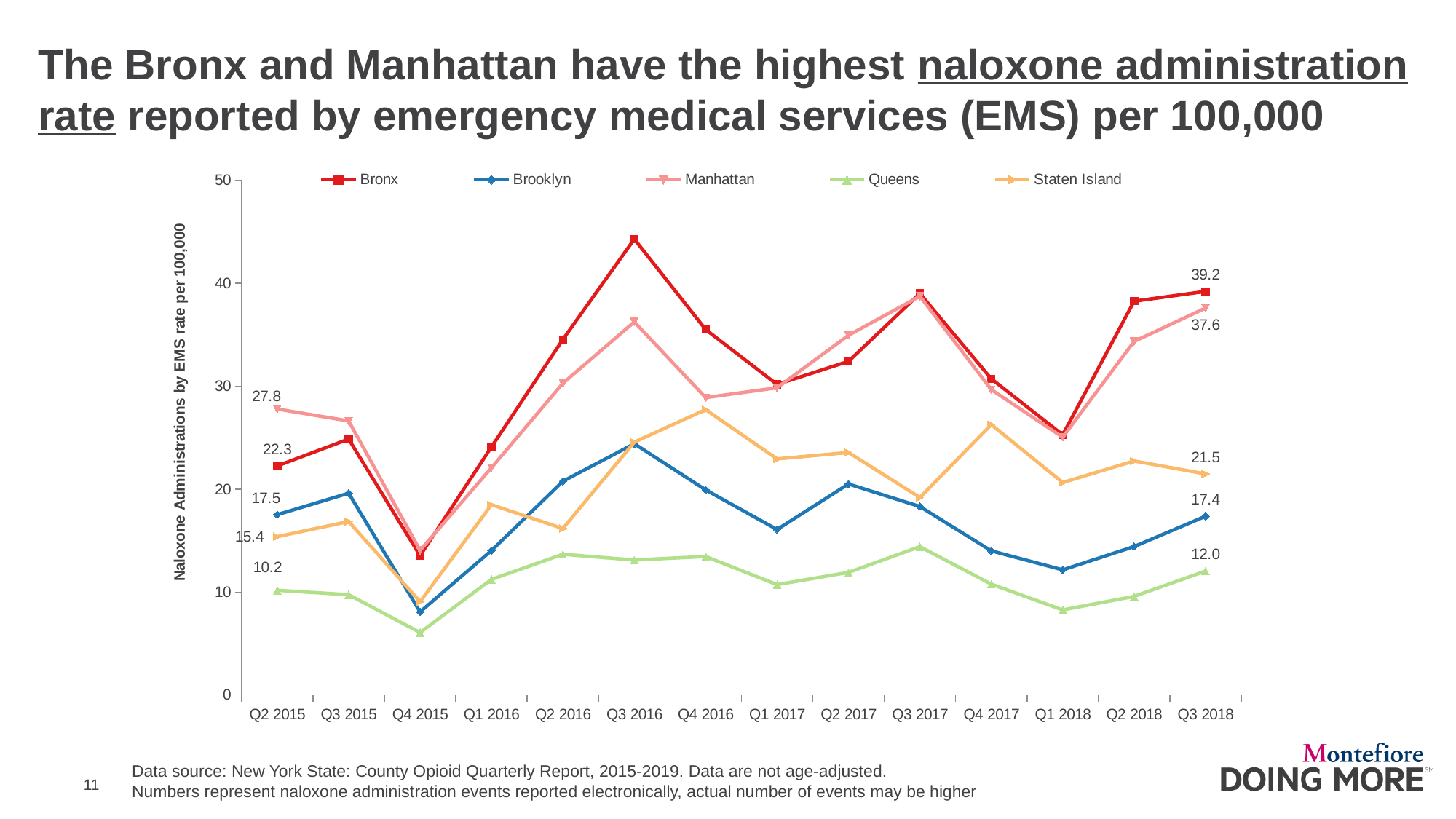
What is the naloxone administration rate for the Bronx in Q3 2018? 39.2 What is the naloxone administration rate for Manhattan in Q2 2015? 27.8 Which borough has the highest naloxone administration rate in Q3 2018? Bronx What type of chart is shown on the slide? line chart Which is larger in Q2 2015, the Brooklyn rate or the Staten Island rate? Brooklyn Is the Bronx rate in Q3 2016 greater or less than 40? greater What is the naloxone administration rate for Staten Island in Q2 2015? 15.4 How many series does the legend list? 5 What is the difference between the Bronx and Manhattan rates in Q3 2018? 1.6 Which borough has the lowest naloxone administration rate in Q2 2015? Queens What is the naloxone administration rate for Queens in Q3 2018? 12.0 How many quarters are plotted along the x axis? 14